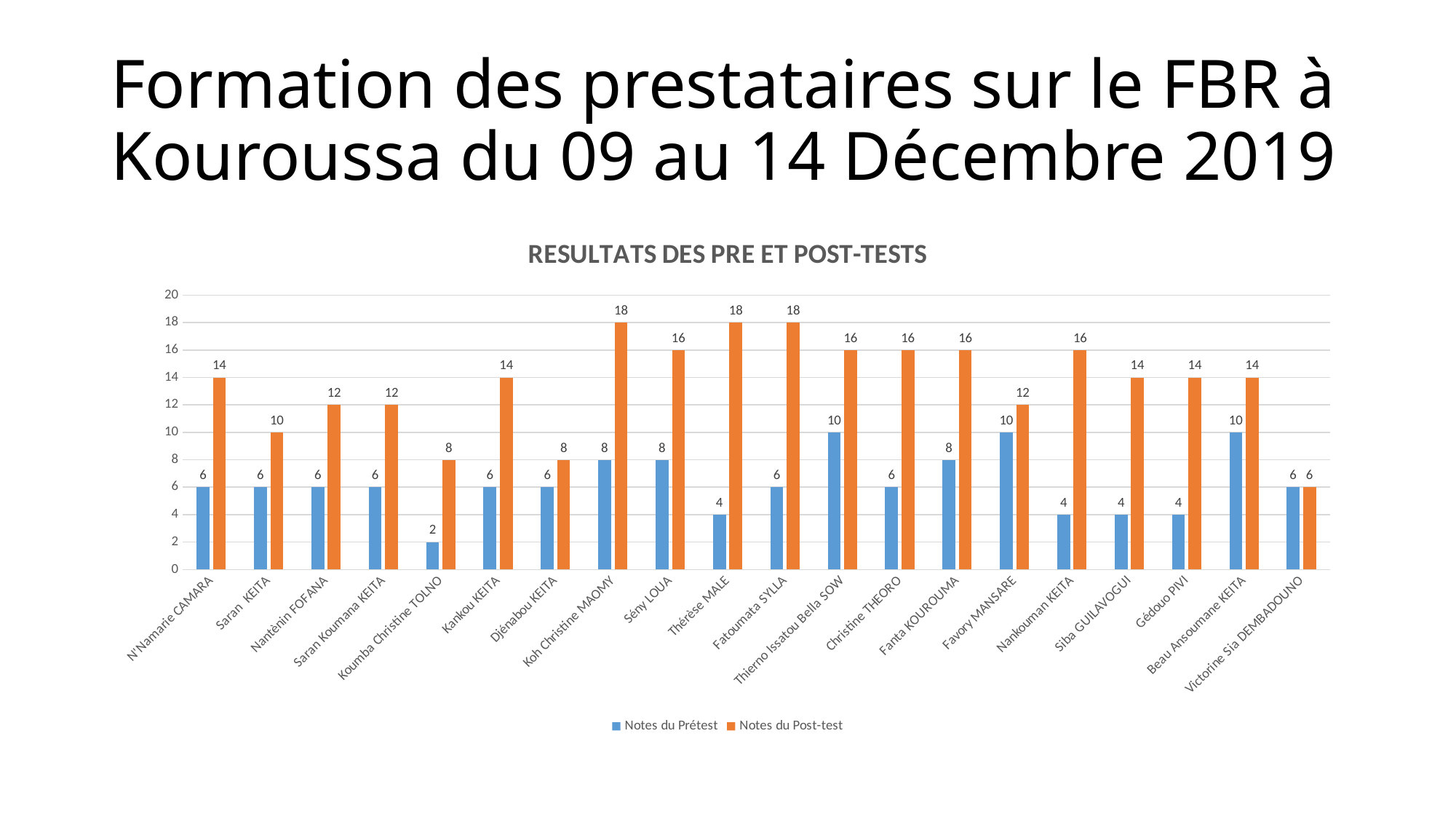
Which participant has the lowest Notes du Post-test value? Victorine Sia DEMBADOUNO How many participants are shown on the x axis? 20 What is the Notes du Post-test value for Koh Christine MAOMY? 18 What is the Notes du Prétest value for Koumba Christine TOLNO? 2 Which colour represents Notes du Post-test in the chart? Orange What kind of chart is shown on the slide? Bar chart Which participant has the lowest Notes du Prétest value? Koumba Christine TOLNO What is the title of the chart? RESULTATS DES PRE ET POST-TESTS How many series does the legend list? 2 Which is larger for Favory MANSARE: Notes du Prétest or Notes du Post-test? Notes du Post-test What is the Notes du Post-test value for Saran KEITA? 10 What is the difference between the Notes du Post-test and Notes du Prétest values for Thérèse MALE? 14